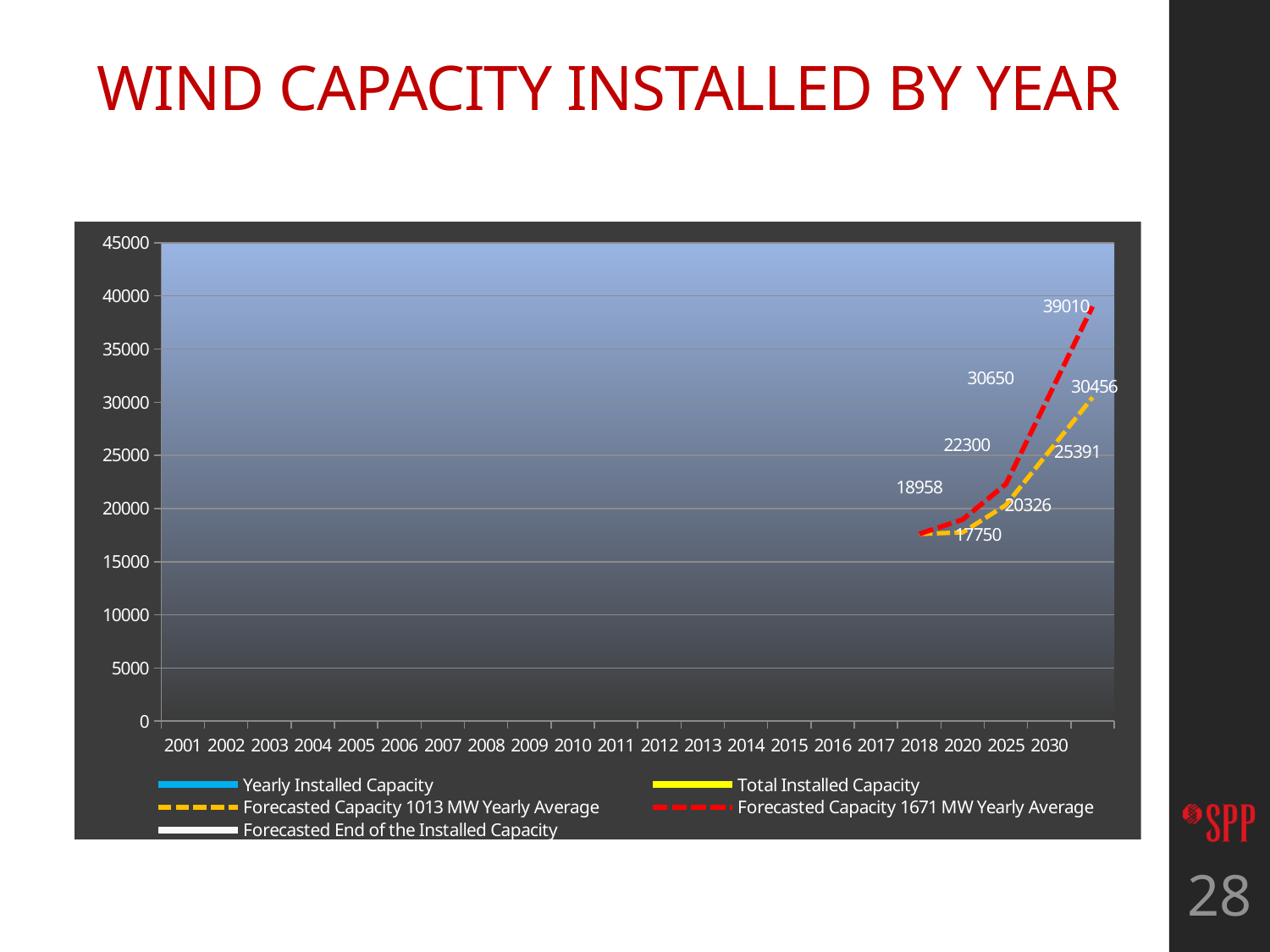
How many series does the legend list? 5 What type of chart is shown on the slide? line chart What is the value of the Forecasted Capacity 1013 MW Yearly Average series in 2020? 17750 What is the difference between the two forecast series in 2025 (30650 and 25391)? 5259 What is the value of the Forecasted Capacity 1013 MW Yearly Average series in 2030? 25391 What is the value of the Forecasted Capacity 1671 MW Yearly Average series in 2025? 22300 What is the value of the Forecasted Capacity 1671 MW Yearly Average series in 2030? 30650 What is the title of the chart? WIND CAPACITY INSTALLED BY YEAR Which forecast series is higher in 2025, the 1671 MW Yearly Average or the 1013 MW Yearly Average? Forecasted Capacity 1671 MW Yearly Average What is the difference between the two forecast series in 2030 (39010 and 30456)? 8554 Do the forecast lines rise or fall from 2018 to 2030? rise